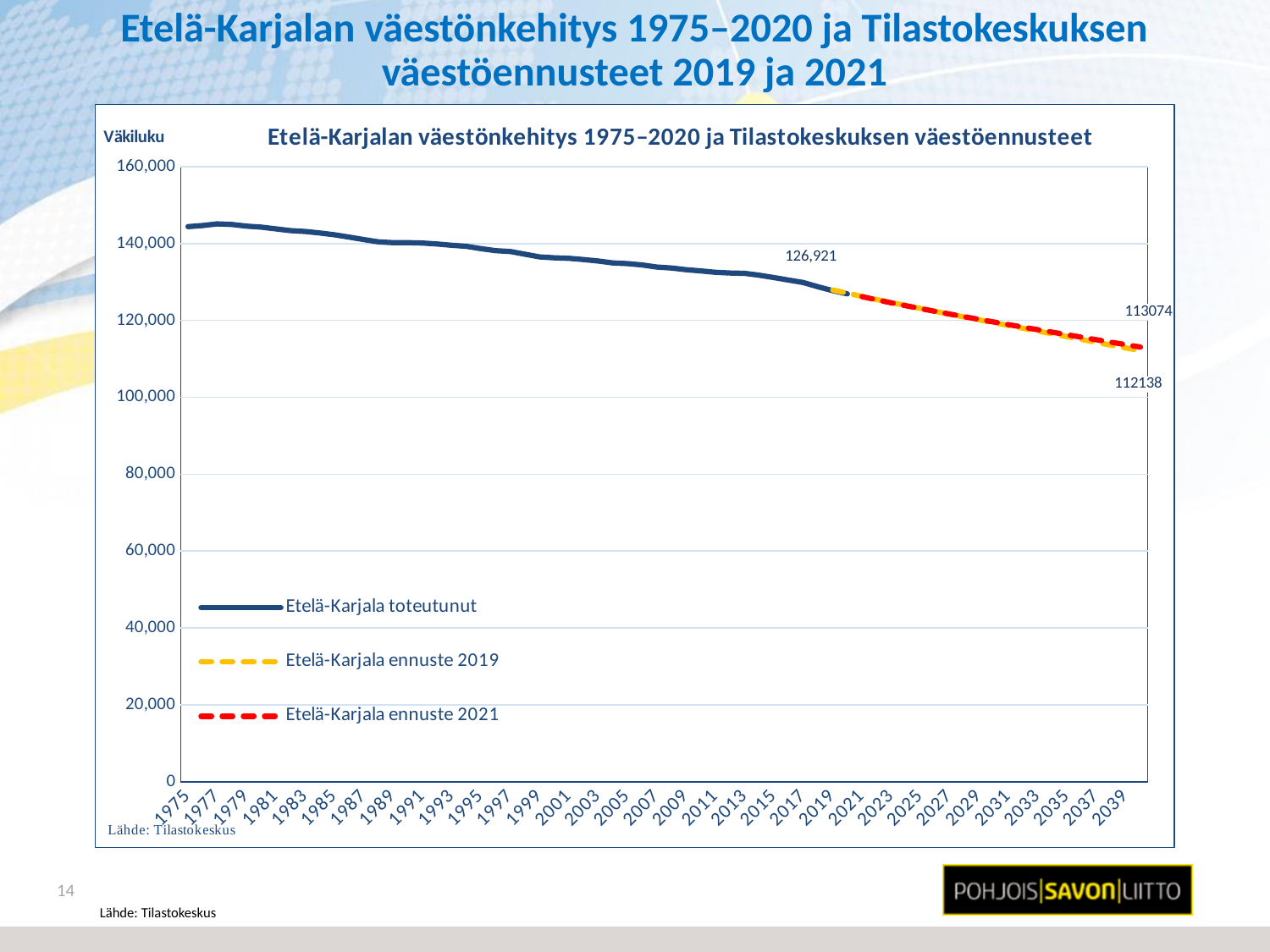
What is the data label printed on the 'Etelä-Karjala toteutunut' line near 2019? 126,921 What is the difference between the two end-of-forecast labels 113074 and 112138? 936 What is the higher of the two data labels printed at the right end of the forecast lines? 113074 What is the lower of the two data labels printed at the right end of the forecast lines? 112138 What is the label on the vertical axis of the chart? Väkiluku Does the population shown in the chart rise or fall from 1975 to 2039? fall How many series does the chart legend list? 3 Is the value of the 'Etelä-Karjala toteutunut' line in 2001 greater or less than 140,000? less Is the value of the 'Etelä-Karjala toteutunut' line in 1975 greater or less than 140,000? greater Which series is drawn with a red dashed line? Etelä-Karjala ennuste 2021 Is the value of the 'Etelä-Karjala toteutunut' line in 2011 greater or less than 120,000? greater What kind of chart is shown on the slide? line chart